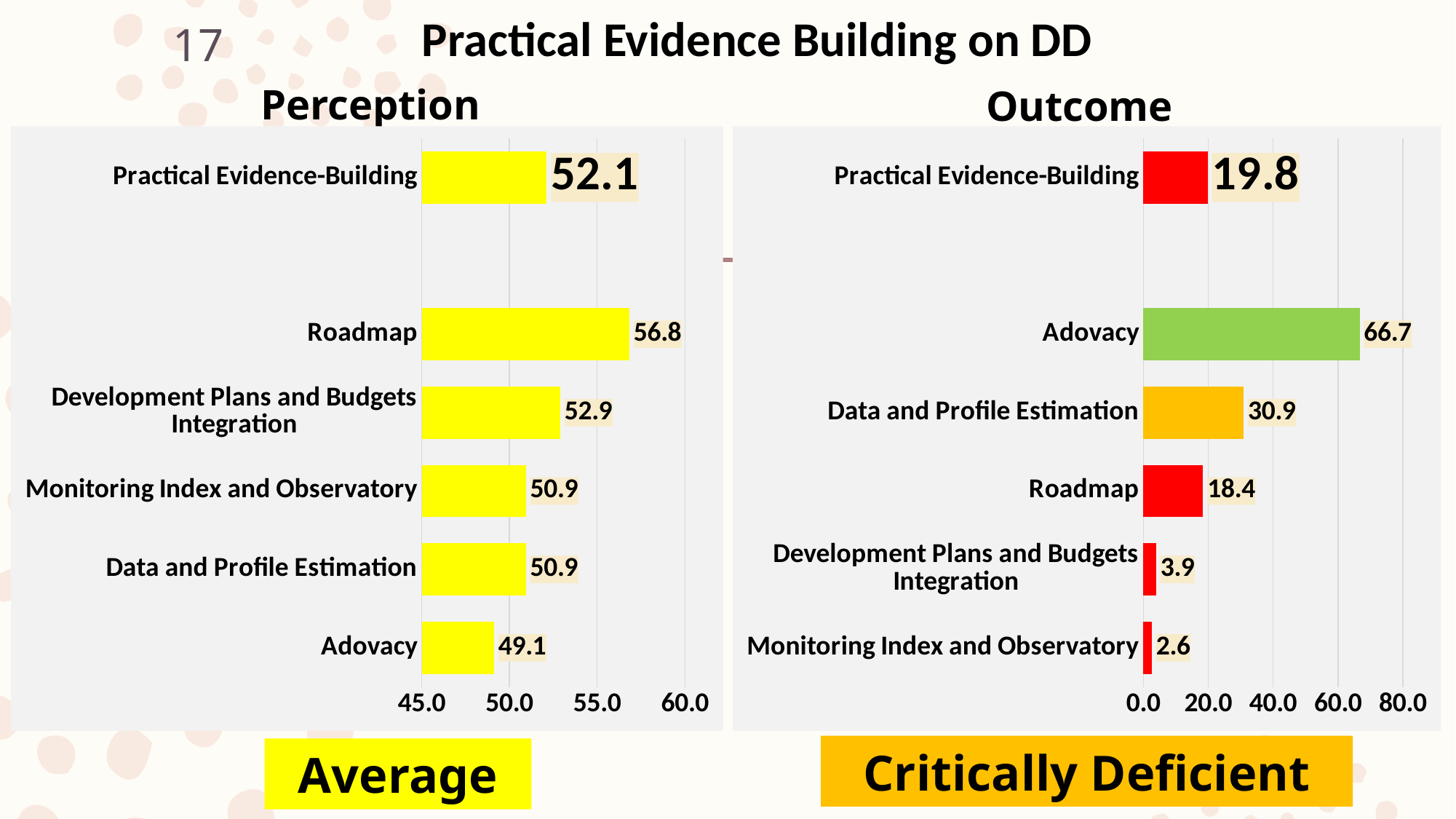
What colour is the Adovacy bar in the Outcome chart? Green In the Outcome chart, which category has the lowest value? Monitoring Index and Observatory In the Outcome chart, what is the difference between the values for Adovacy and Roadmap? 48.3 In the Perception chart, which category has the highest value? Roadmap In the Outcome chart, what is the value for Practical Evidence-Building? 19.8 In the Perception chart, what is the value for Roadmap? 56.8 In the Outcome chart, what is the value for Data and Profile Estimation? 30.9 How many bars are plotted in the Outcome chart? 6 What type of chart is the Perception chart? Bar chart In the Perception chart, which category has the lowest value? Adovacy In the Perception chart, which is larger: the value for Development Plans and Budgets Integration or the value for Adovacy? Development Plans and Budgets Integration In the Outcome chart, which category has the highest value? Adovacy